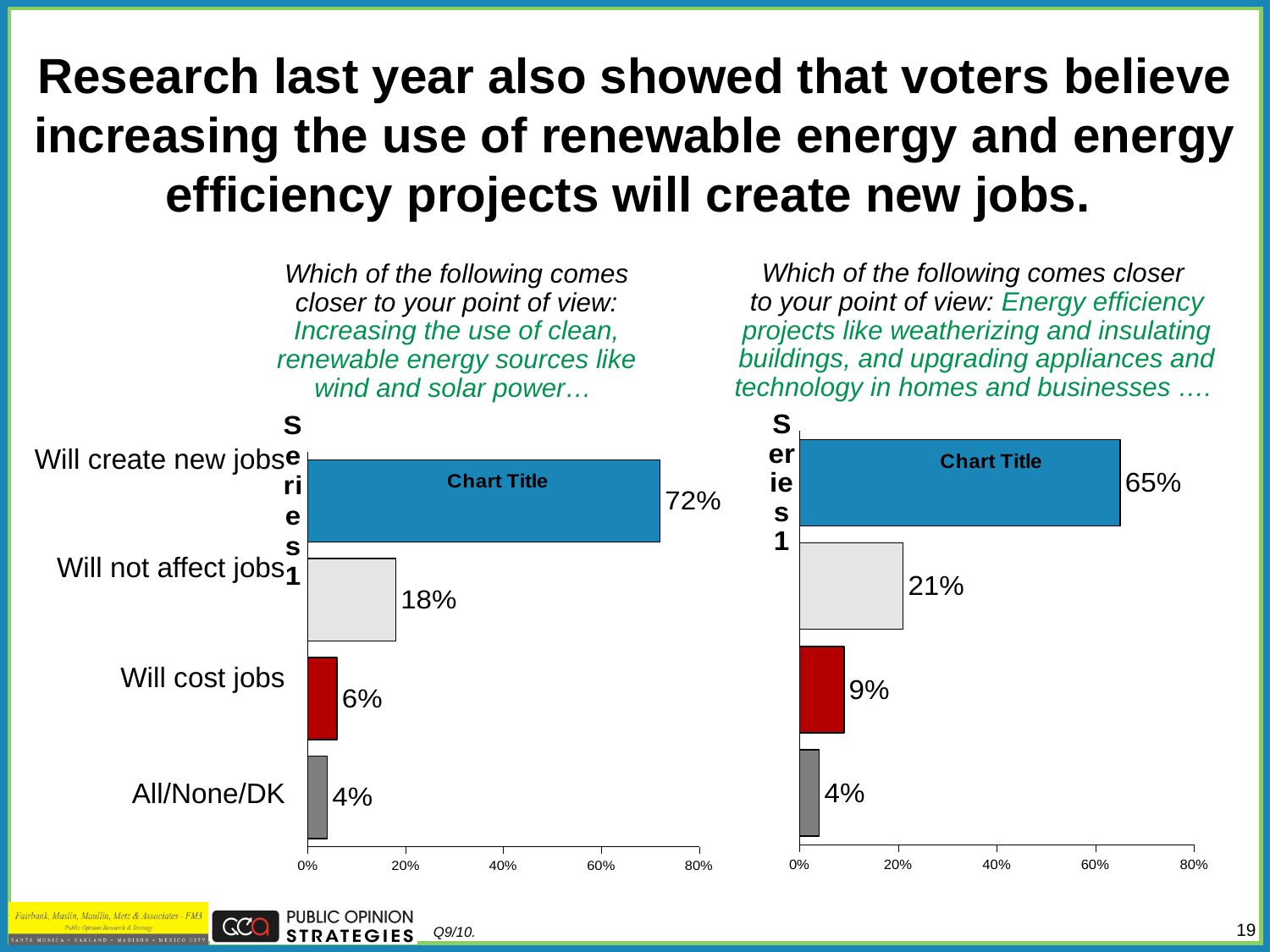
In the left chart (renewable energy sources like wind and solar power), what percentage of voters said it will create new jobs? 72% In the right chart, is the value for 'Will not affect jobs' greater or less than 20%? greater In the right chart, what is the value for 'Will cost jobs'? 9% What type of chart is used on this slide? Bar chart In the left chart, what is the value for 'Will not affect jobs'? 18% In the right chart (energy efficiency projects), what percentage of voters said it will create new jobs? 65% In the right chart, which category has the highest value? Will create new jobs In the left chart, what is the difference between 'Will create new jobs' and 'Will not affect jobs'? 54 percentage points In the left chart, which category has the lowest value? All/None/DK How many categories are shown in the left chart? 4 What is the value for 'All/None/DK' in the right chart? 4% Which is larger: 'Will cost jobs' in the left chart or 'Will cost jobs' in the right chart? Right chart (9%)